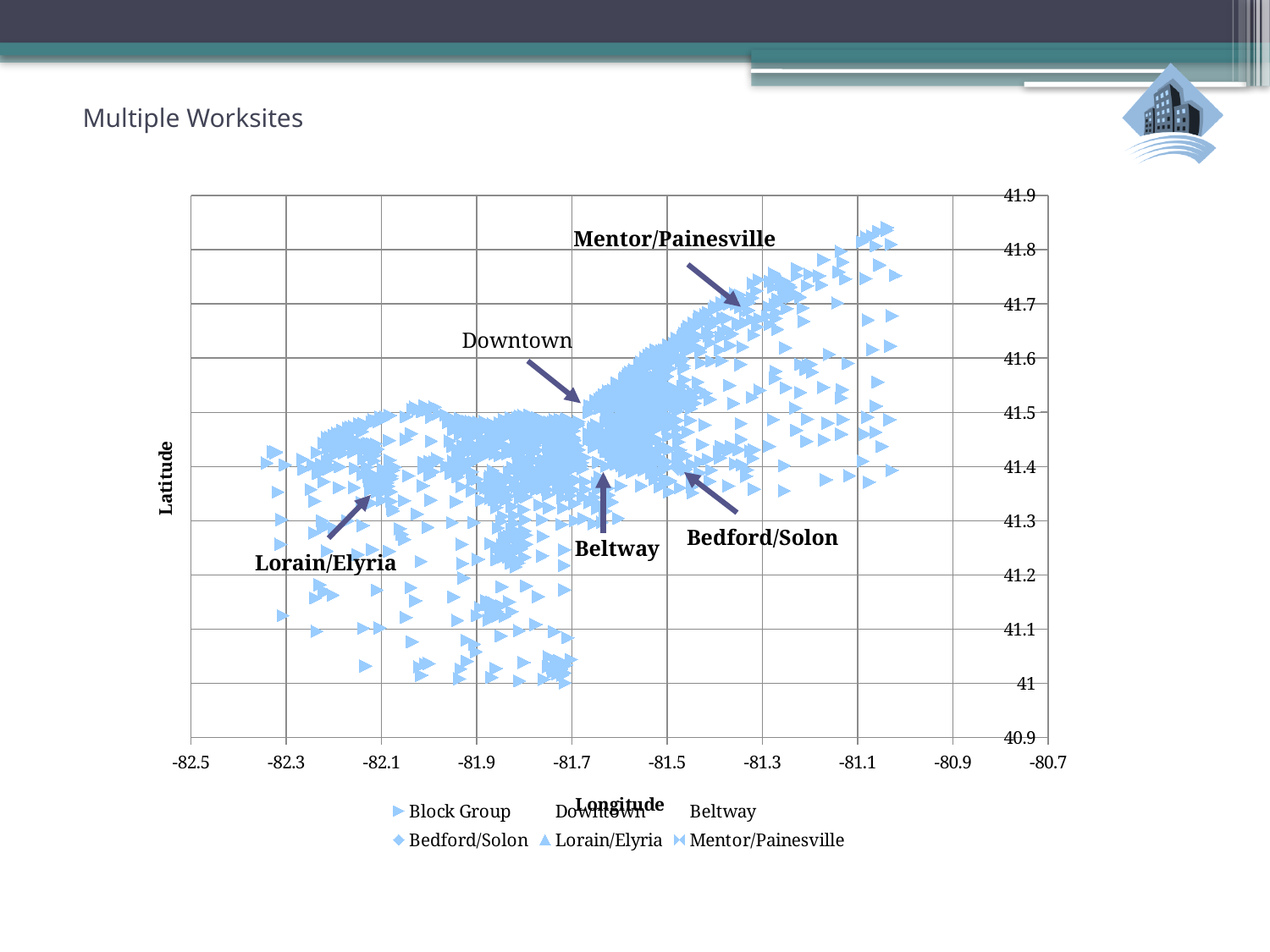
What kind of chart is shown on the slide? Scatter chart Which labelled worksite is furthest west (lowest longitude)? Lorain/Elyria Which labelled worksite has the higher latitude, Mentor/Painesville or Beltway? Mentor/Painesville Is the latitude of the Downtown worksite greater or less than 41.4? greater What is the label of the vertical axis? Latitude How many worksites are labelled with arrows on the chart? 5 What is the label of the horizontal axis? Longitude Is the latitude of the Mentor/Painesville worksite greater or less than 41.8? less Which labelled worksite has the highest latitude? Mentor/Painesville How many series does the legend list? 6 Is the latitude of the Mentor/Painesville worksite greater or less than 41.6? greater